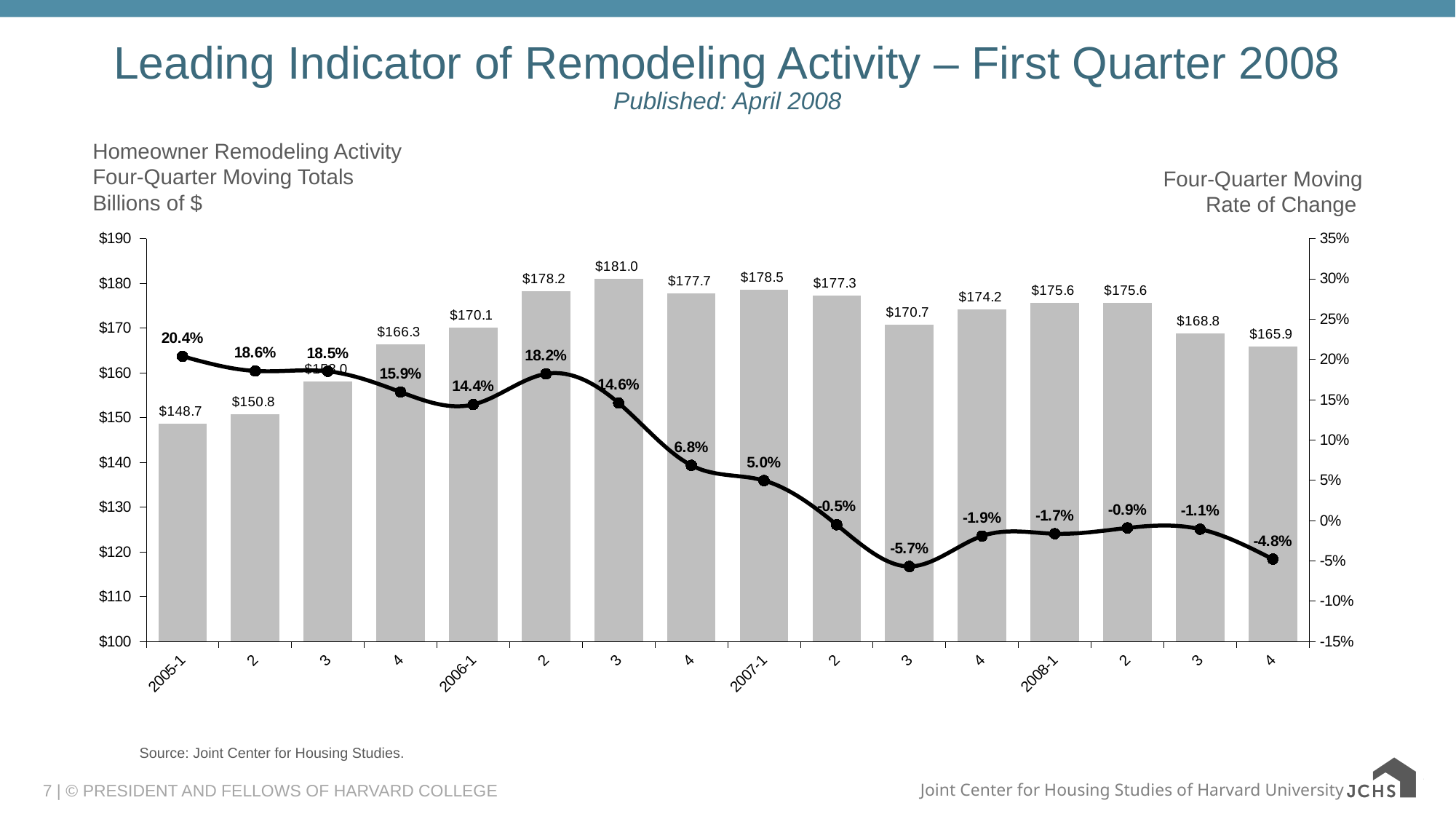
How many quarters are shown on the x axis? 16 Which quarter has the highest four-quarter moving rate of change? 2005-1 Does the four-quarter moving rate of change generally rise or fall from 2005-1 to 2008-4? fall Which is larger, the four-quarter moving total for 2007-1 or for 2007-2? 2007-1 What is the four-quarter moving rate of change for 2007-3? -5.7% Is the four-quarter moving rate of change for 2006-4 greater or less than 10%? less Which quarter has the highest four-quarter moving total? 2006-3 What is the four-quarter moving total for 2006-3? $181.0 What kind of chart is this? Combined bar and line chart What is the four-quarter moving total for 2008-4? $165.9 What is the difference between the four-quarter moving totals for 2006-3 and 2005-1? $32.3 Which quarter has the lowest four-quarter moving total? 2005-1